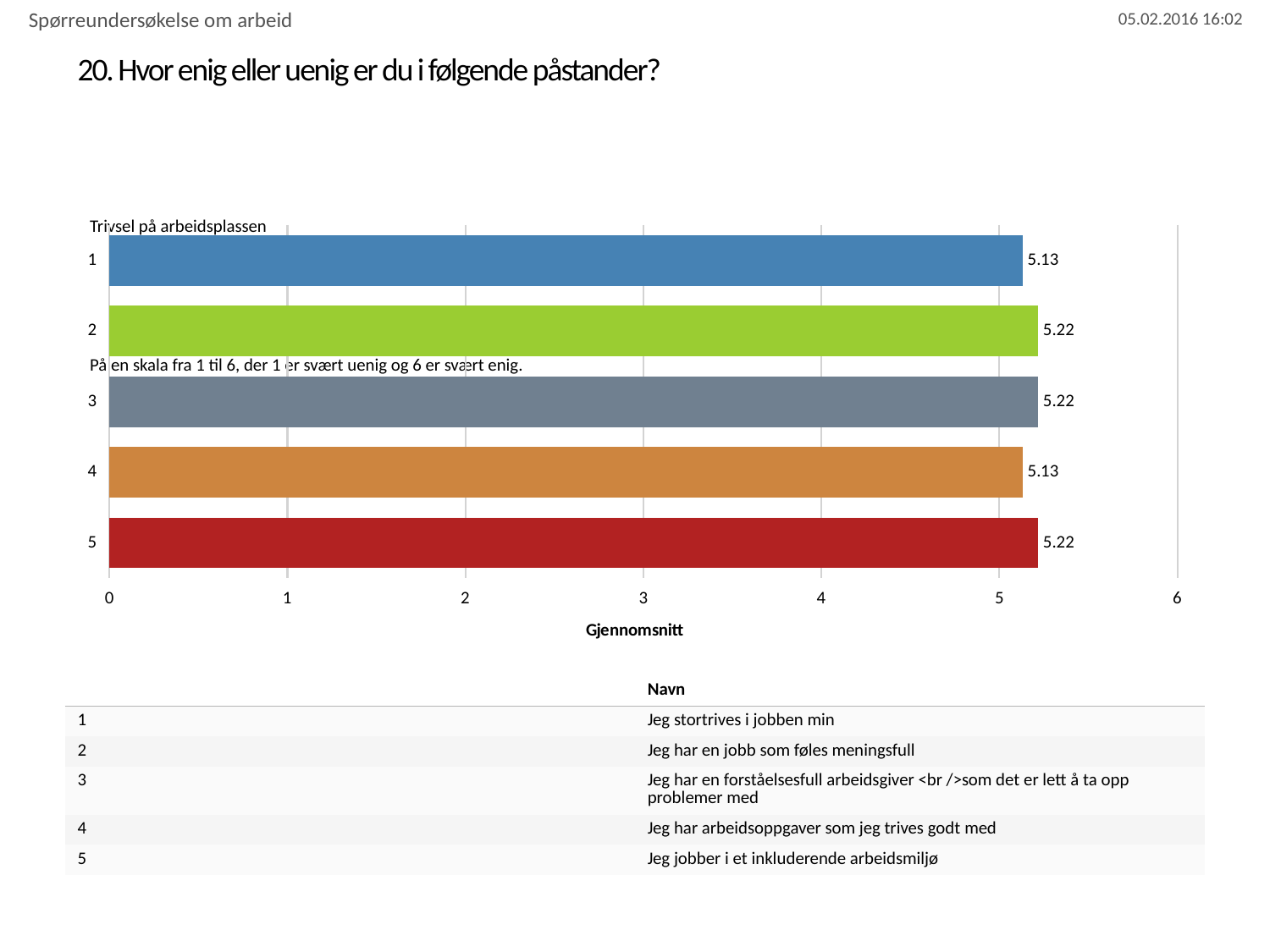
What is the value for category 4? 5.13 What is the value for category 5? 5.22 What is the value for category 1? 5.13 What is the label of the horizontal axis? Gjennomsnitt Is the value for category 5 greater or less than 6? less Is the value for category 4 greater or less than 5? greater How many categories are shown in the chart? 5 What is the value for category 2? 5.22 What kind of chart is shown on the slide? Bar chart Which has the larger value, category 1 or category 2? Category 2 What is the title of the chart? Trivsel på arbeidsplassen What is the difference between the values for category 3 and category 4? 0.09